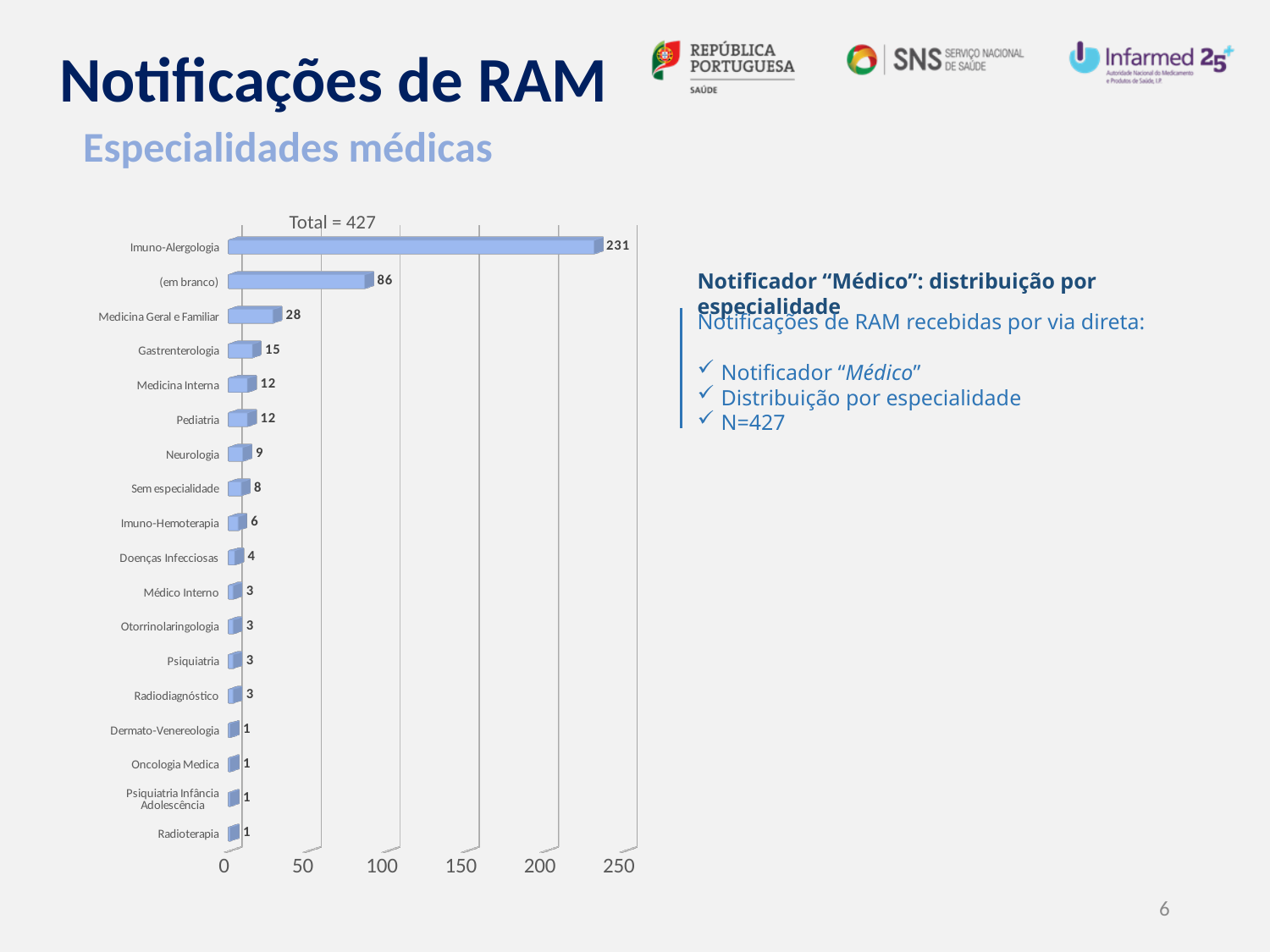
What is the value for Medicina Geral e Familiar? 28 What is the difference between the values for Imuno-Alergologia and (em branco)? 145 What total is stated in the chart's title? Total = 427 What kind of chart is shown on the slide? bar chart How many categories are shown in the chart? 18 Is the value for (em branco) greater or less than 100? less What is the value for Imuno-Alergologia? 231 Which is larger, the value for Sem especialidade or the value for Imuno-Hemoterapia? Sem especialidade What is the difference between the values for Medicina Geral e Familiar and Gastrenterologia? 13 What is the value for Neurologia? 9 What is the value for Gastrenterologia? 15 Which category has the highest value? Imuno-Alergologia